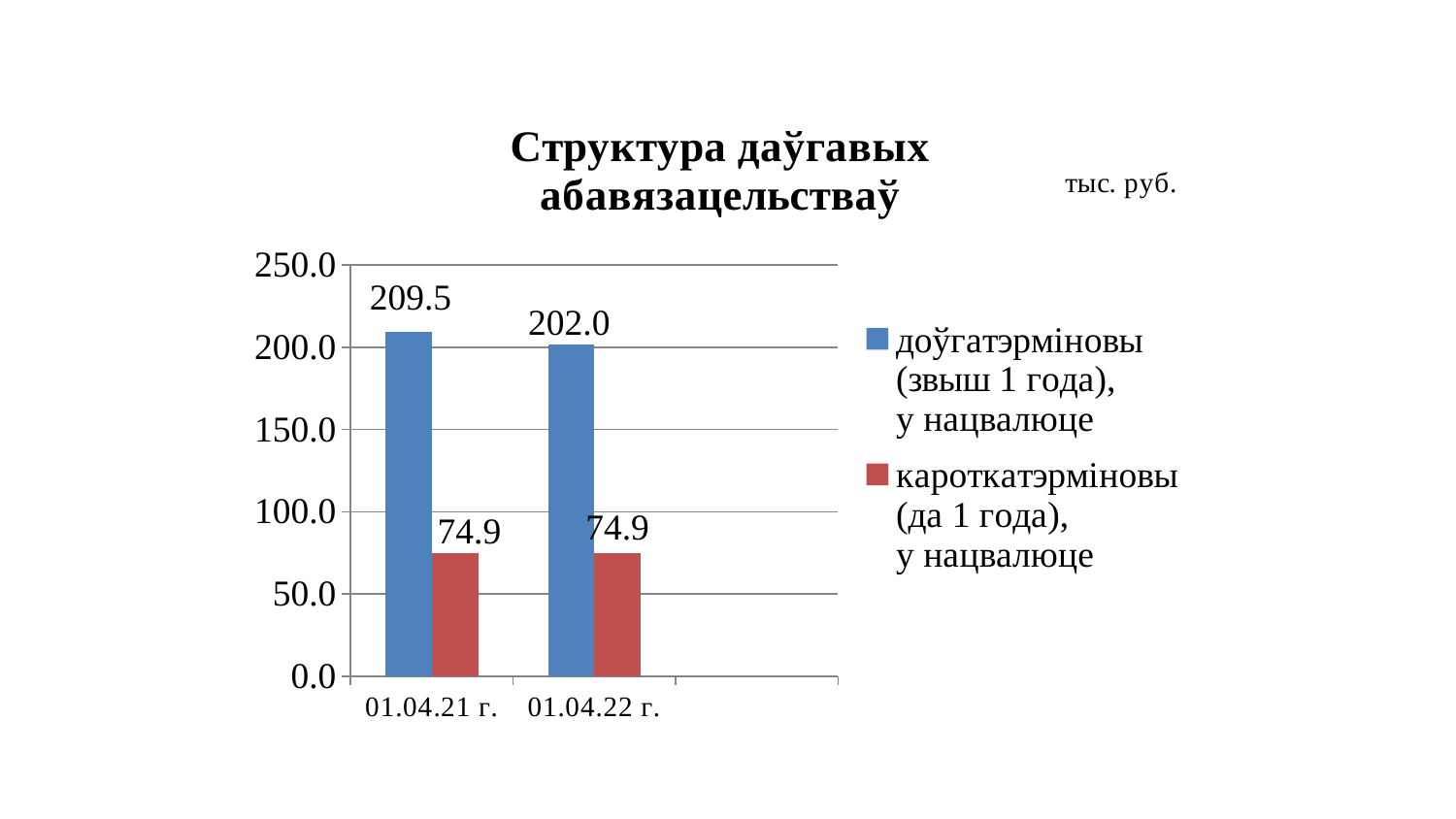
What is the difference between the long-term values for 01.04.21 г. and 01.04.22 г.? 7.5 How many dates (categories) are shown on the x axis? 2 What kind of chart is shown on the slide? bar chart Does the long-term (доўгатэрміновы) series rise or fall from 01.04.21 г. to 01.04.22 г.? fall How many series does the legend list? 2 What is the value of the long-term (доўгатэрміновы) series for 01.04.21 г.? 209.5 What is the value of the short-term (кароткатэрміновы) series for 01.04.22 г.? 74.9 Which is larger for 01.04.21 г.: the long-term value or the short-term value? long-term (доўгатэрміновы) What is the value of the long-term (доўгатэрміновы) series for 01.04.22 г.? 202.0 What is the difference between the long-term and short-term values for 01.04.22 г.? 127.1 Which date has the higher value for the long-term (доўгатэрміновы) series? 01.04.21 г. What is the value of the short-term (кароткатэрміновы) series for 01.04.21 г.? 74.9